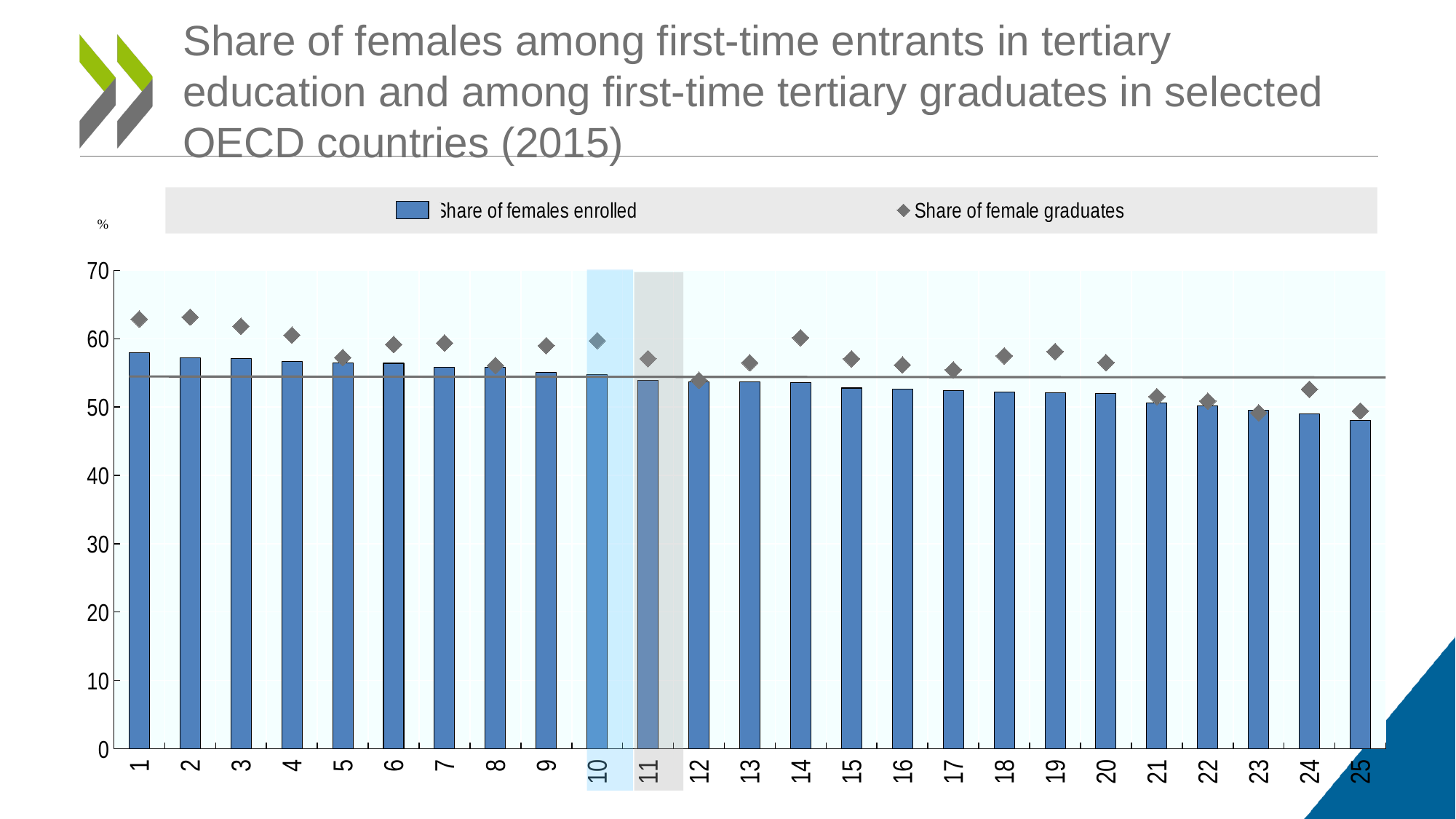
Which has the larger share of females enrolled, category 1 or category 25? Category 1 Is the share of females enrolled for category 25 greater or less than 50? less Which series is shown with diamond markers? Share of female graduates What kind of chart is shown on the slide? Bar chart with diamond markers How many series does the legend list? 2 How many countries (categories) are plotted along the x axis? 25 Do the bars for share of females enrolled rise or fall from category 1 to category 25? Fall Is the share of females enrolled for category 12 greater or less than 60? less Is the share of female graduates for category 2 greater or less than 60? greater Which series is shown with blue bars? Share of females enrolled